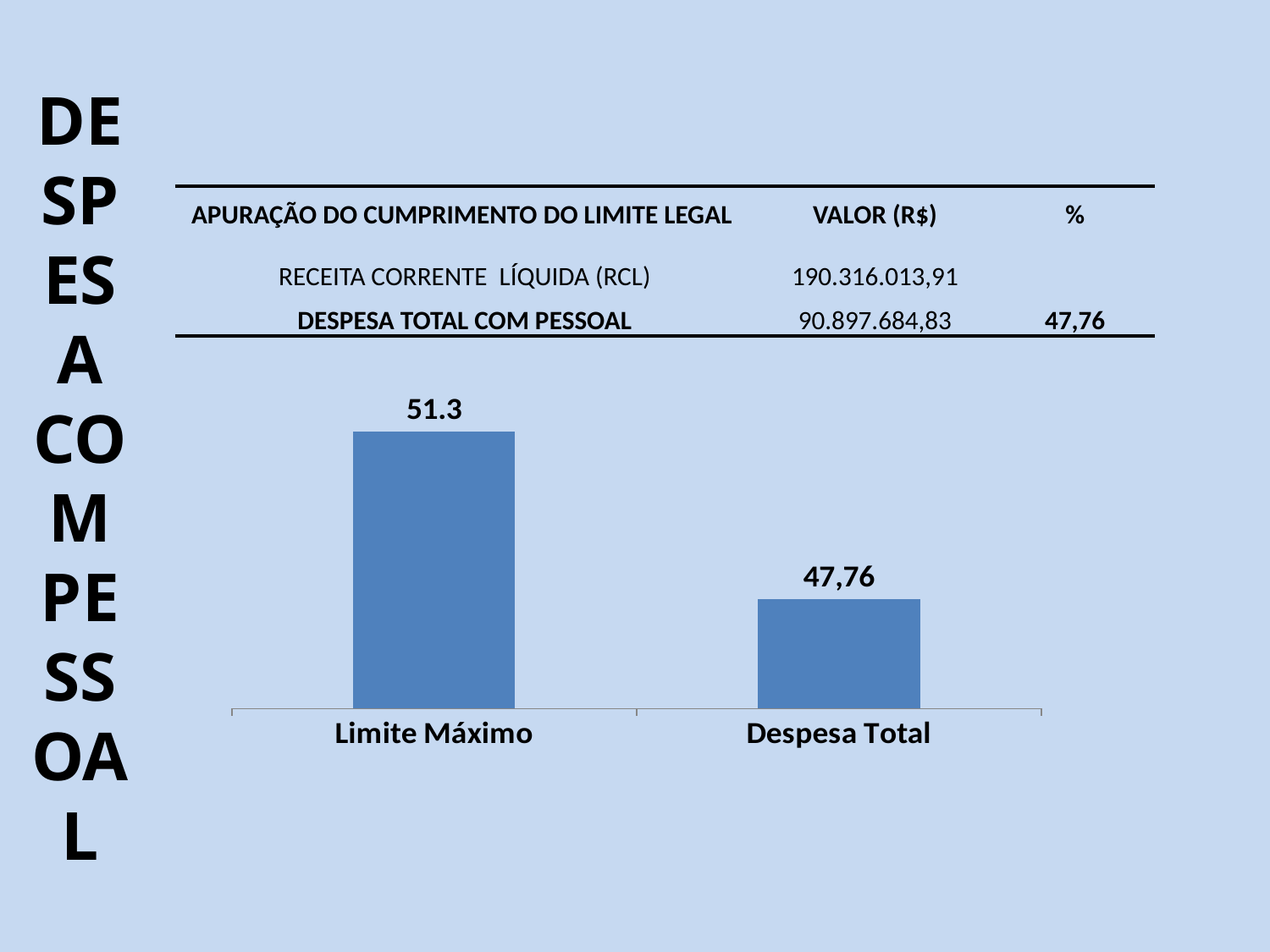
Which is larger in the bar chart, Limite Máximo or Despesa Total? Limite Máximo How many bars are plotted in the chart? 2 What colour are the bars in the chart? Blue What is the label of the first category on the x axis of the bar chart? Limite Máximo Do the bar values rise or fall from left to right across the chart? Fall Which category has the highest bar in the chart? Limite Máximo What is the value shown for Limite Máximo in the bar chart? 51.3 What is the value shown for Despesa Total in the bar chart? 47,76 What kind of chart is shown on the slide? Bar chart Which category has the lowest bar in the chart? Despesa Total